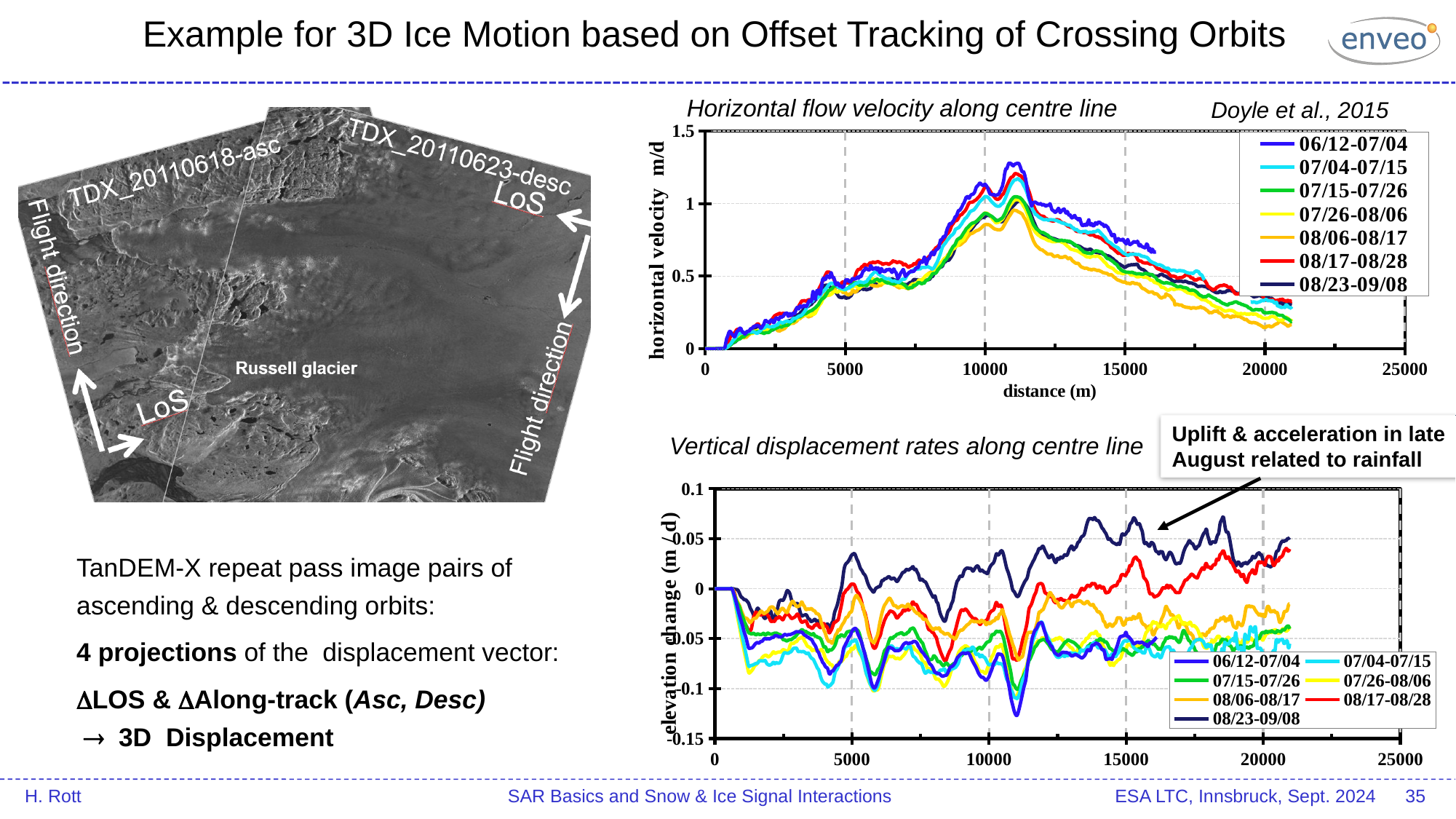
What is the largest tick value shown on the x axis of the 'Vertical displacement rates along centre line' chart? 25000 How many series does the legend of the 'Horizontal flow velocity along centre line' chart list? 7 What kind of chart is the 'Horizontal flow velocity along centre line' chart? line chart In the 'Horizontal flow velocity along centre line' chart, is the peak value of the 06/12-07/04 series greater or less than 1? greater How many series does the legend of the 'Vertical displacement rates along centre line' chart list? 7 In the 'Vertical displacement rates along centre line' chart, is the minimum value of the 06/12-07/04 series near 11000 m greater or less than -0.1? less In the 'Horizontal flow velocity along centre line' chart, which series reaches the highest peak velocity? 06/12-07/04 What is the x-axis label of the 'Horizontal flow velocity along centre line' chart? distance (m) In the 'Horizontal flow velocity along centre line' chart, at 10000 m, which series has the larger velocity: 06/12-07/04 or 08/06-08/17? 06/12-07/04 In the 'Vertical displacement rates along centre line' chart, is the value of the 08/23-09/08 series at about 14000 m greater or less than 0.05? greater In the 'Vertical displacement rates along centre line' chart, at 15000 m, which series has the larger value: 08/23-09/08 or 06/12-07/04? 08/23-09/08 In the 'Horizontal flow velocity along centre line' chart, do the velocities rise or fall along the x axis between 15000 m and 20000 m? fall